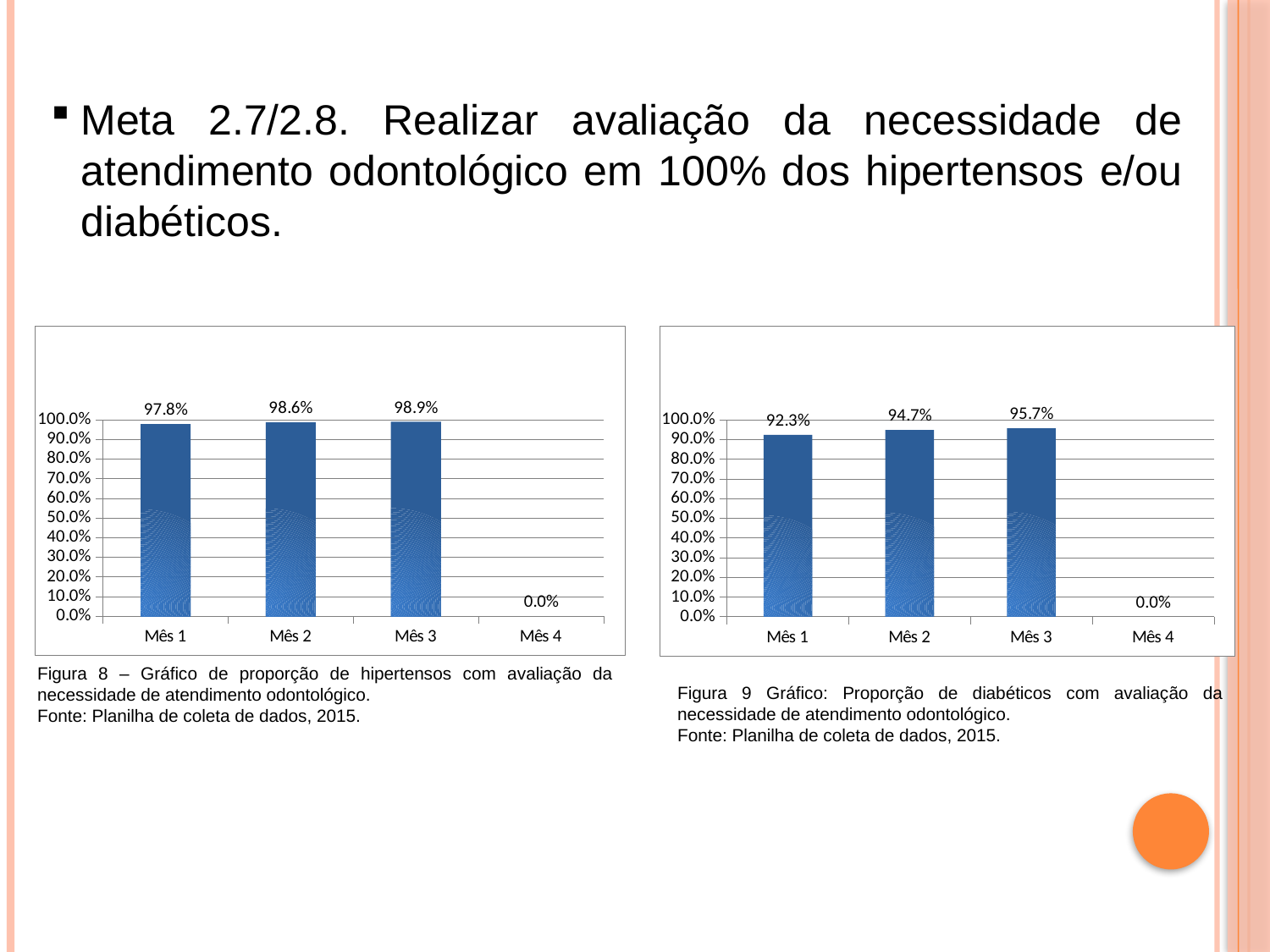
In the left chart (Figura 8, hipertensos), what is the value for Mês 1? 97.8% In the right chart (Figura 9, diabéticos), which month has the highest value? Mês 3 In the right chart (Figura 9, diabéticos), what is the value for Mês 2? 94.7% What kind of chart is the right chart (Figura 9)? Bar chart In the right chart (Figura 9, diabéticos), do the values rise or fall from Mês 1 to Mês 3? Rise In the right chart (Figura 9, diabéticos), what is the difference between the values for Mês 3 and Mês 1? 3.4% In the left chart (Figura 8, hipertensos), what is the difference between the values for Mês 2 and Mês 1? 0.8% In the left chart (Figura 8, hipertensos), which month has the lowest value? Mês 4 How many months (categories) are shown on the x axis of the left chart (Figura 8)? 4 Which is larger: the Mês 1 value in the left chart (hipertensos) or the Mês 1 value in the right chart (diabéticos)? Left chart (hipertensos), 97.8% In the left chart (Figura 8, hipertensos), what is the value for Mês 3? 98.9% In the right chart (Figura 9, diabéticos), what is the value for Mês 4? 0.0%